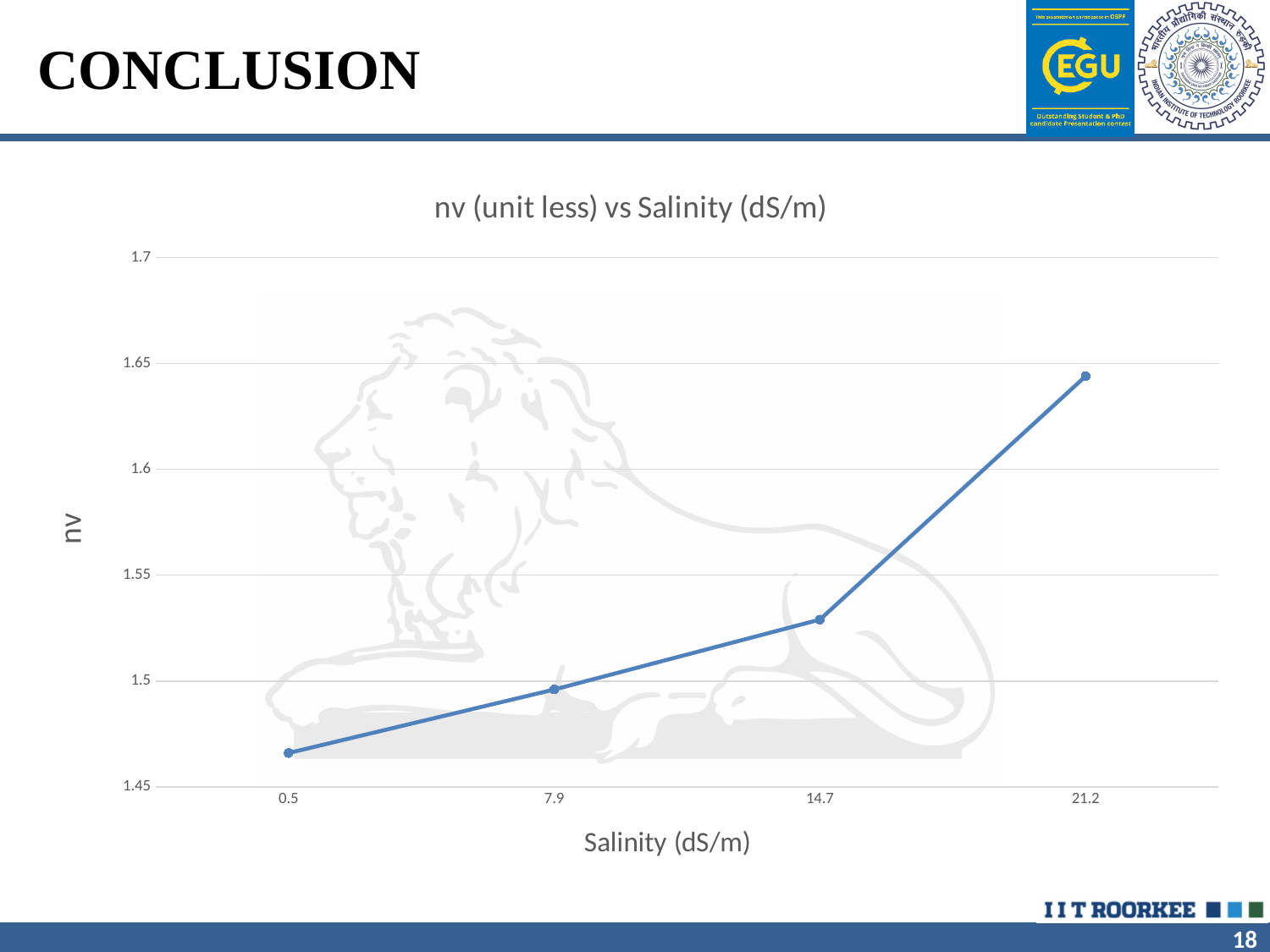
What kind of chart is shown on the slide? line chart Does nv rise or fall as salinity increases along the x axis? rise Is the value of nv at salinity 0.5 greater or less than 1.5? less At which salinity value is nv highest? 21.2 How many data points are plotted on the chart? 4 What is the label of the x axis? Salinity (dS/m) Is the value of nv at salinity 14.7 greater or less than 1.5? greater What is the title of the chart? nv (unit less) vs Salinity (dS/m) At which salinity value is nv lowest? 0.5 Is the value of nv at salinity 14.7 greater or less than 1.55? less Which has the larger nv value: salinity 7.9 or salinity 14.7? 14.7